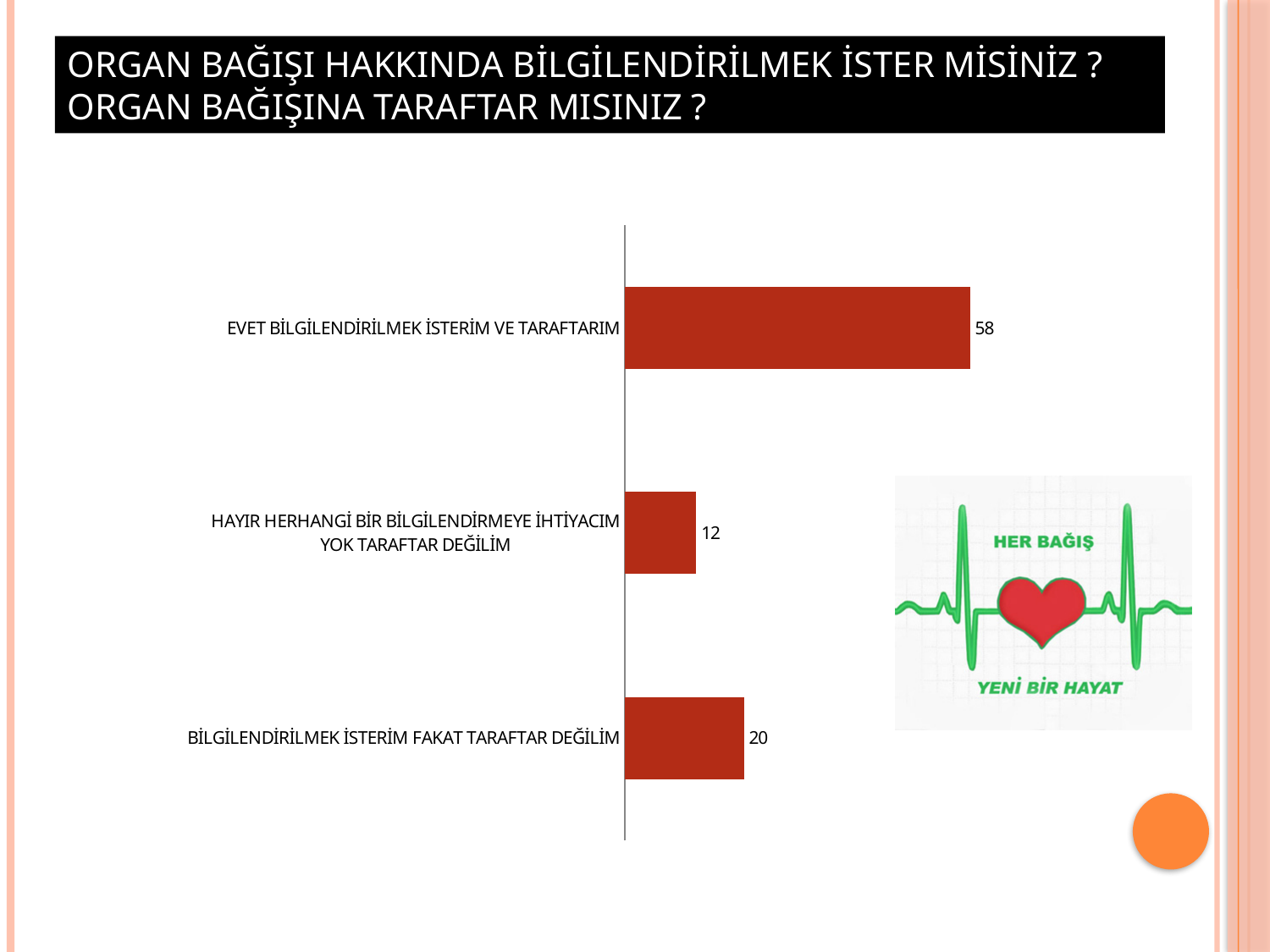
What is the value for HAYIR HERHANGİ BİR BİLGİLENDİRMEYE İHTİYACIM YOK TARAFTAR DEĞİLİM? 12 What is the value for EVET BİLGİLENDİRİLMEK İSTERİM VE TARAFTARIM? 58 Which is larger: the value for BİLGİLENDİRİLMEK İSTERİM FAKAT TARAFTAR DEĞİLİM or the value for HAYIR HERHANGİ BİR BİLGİLENDİRMEYE İHTİYACIM YOK TARAFTAR DEĞİLİM? BİLGİLENDİRİLMEK İSTERİM FAKAT TARAFTAR DEĞİLİM What is the value for BİLGİLENDİRİLMEK İSTERİM FAKAT TARAFTAR DEĞİLİM? 20 What is the difference between the values for EVET BİLGİLENDİRİLMEK İSTERİM VE TARAFTARIM and BİLGİLENDİRİLMEK İSTERİM FAKAT TARAFTAR DEĞİLİM? 38 What colour are the bars in the chart? Red Which category has the highest value? EVET BİLGİLENDİRİLMEK İSTERİM VE TARAFTARIM Which category has the lowest value? HAYIR HERHANGİ BİR BİLGİLENDİRMEYE İHTİYACIM YOK TARAFTAR DEĞİLİM What is the total of the three values shown in the chart? 90 How many categories are shown in the chart? 3 What kind of chart is shown on the slide? Bar chart What is the difference between the values for BİLGİLENDİRİLMEK İSTERİM FAKAT TARAFTAR DEĞİLİM and HAYIR HERHANGİ BİR BİLGİLENDİRMEYE İHTİYACIM YOK TARAFTAR DEĞİLİM? 8